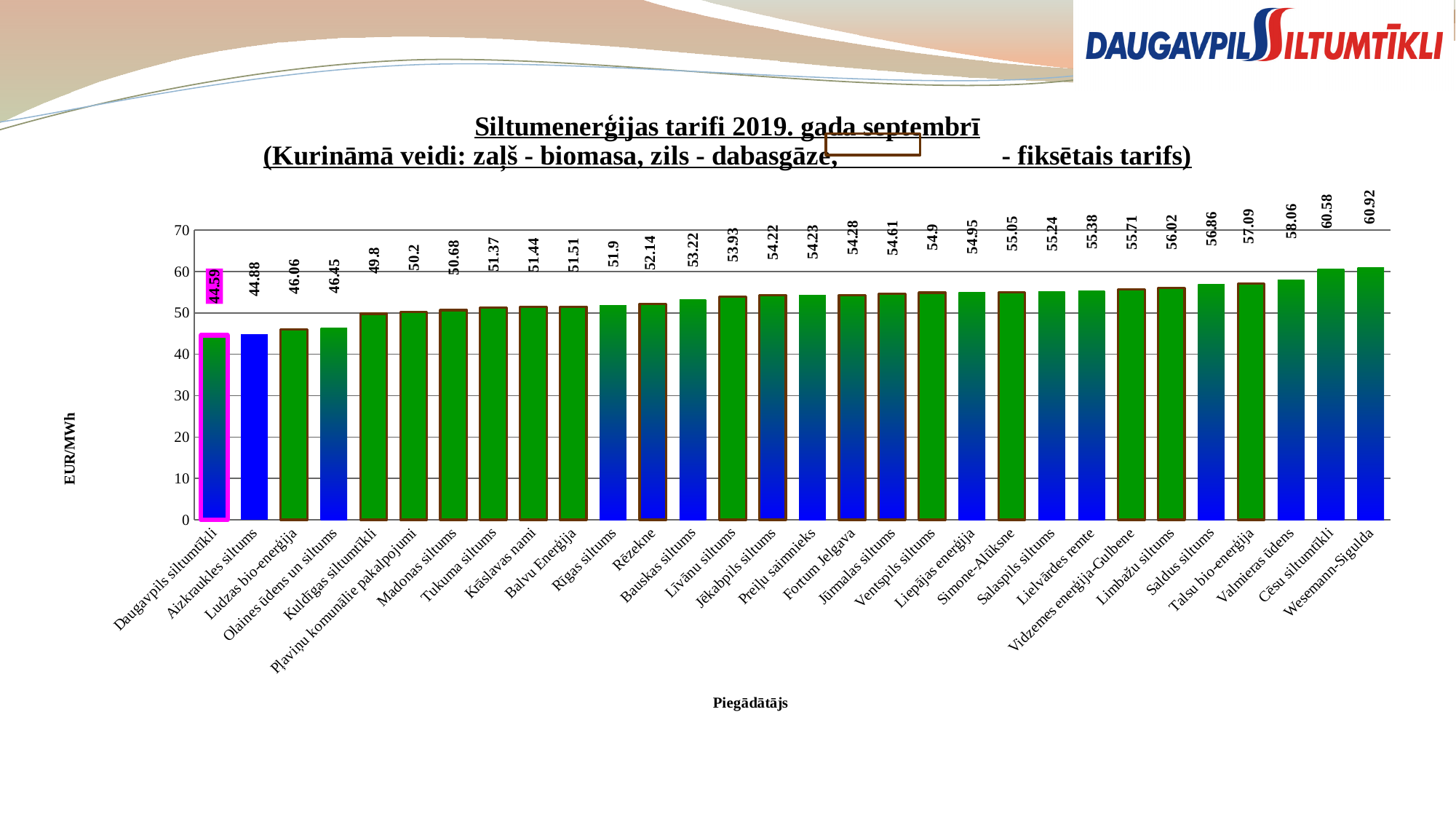
What kind of chart is shown on the slide? Bar chart What is the tariff value shown for Daugavpils siltumtīkli? 44.59 Which supplier has the lowest tariff on the chart? Daugavpils siltumtīkli Which supplier has the highest tariff on the chart? Wesemann-Sigulda What is the tariff value shown for Rīgas siltums? 51.9 Which has a higher tariff, Valmieras ūdens or Saldus siltums? Valmieras ūdens What is the tariff value shown for Cēsu siltumtīkli? 60.58 What unit is shown on the vertical axis of the chart? EUR/MWh What is the difference between the tariffs of Wesemann-Sigulda and Daugavpils siltumtīkli? 16.33 According to the chart title, what fuel type do the green bars represent? Biomasa How many suppliers are shown on the chart? 30 Do the tariff values rise or fall from left to right along the x axis? Rise